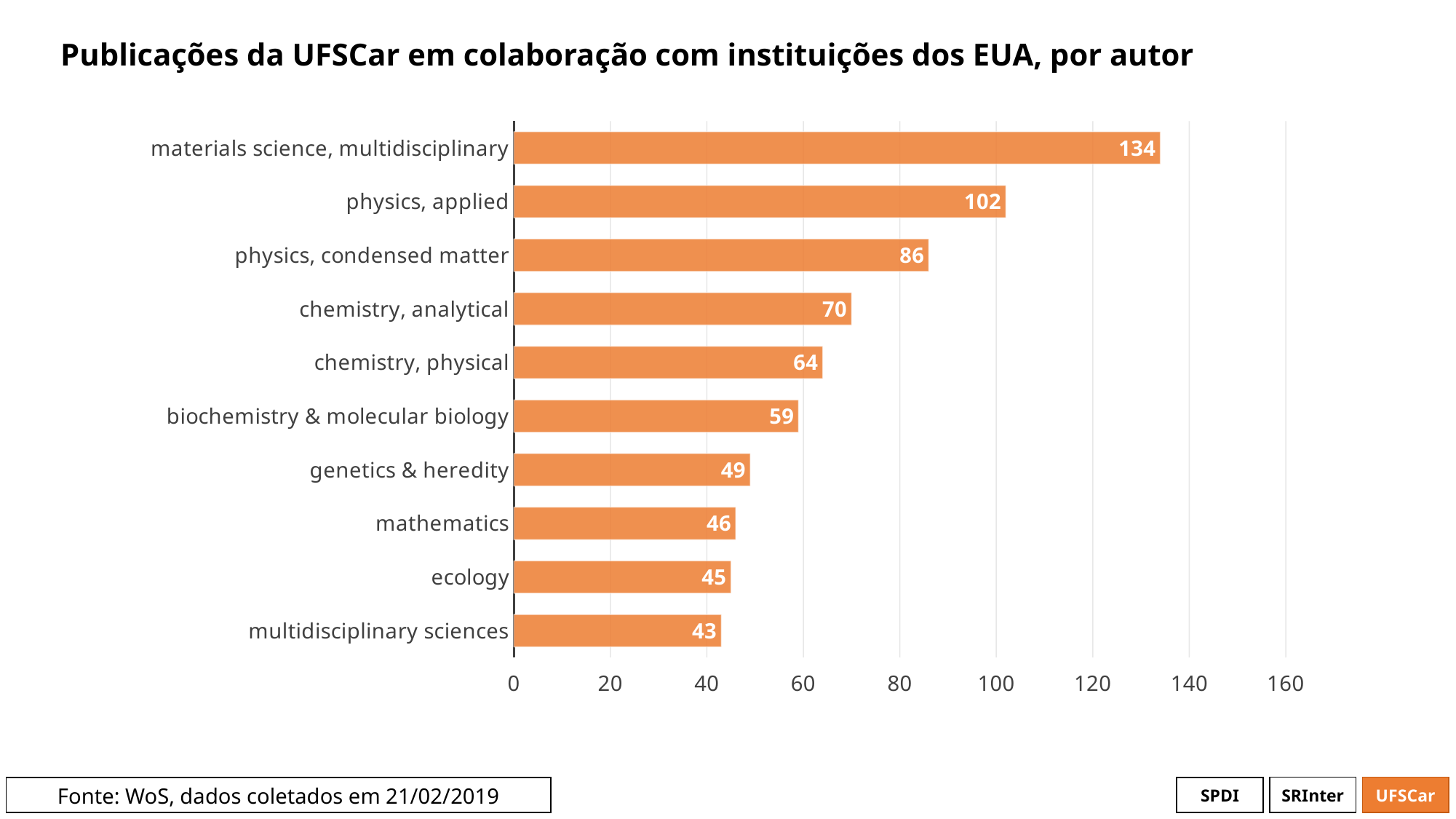
What is the value for ecology? 45 Which category has the highest value? materials science, multidisciplinary What is the title of the chart? Publicações da UFSCar em colaboração com instituições dos EUA, por autor What is the difference between the values for chemistry, analytical and chemistry, physical? 6 Which is larger, the value for genetics & heredity or the value for mathematics? genetics & heredity How many categories are shown in the chart? 10 What is the difference between the values for materials science, multidisciplinary and physics, applied? 32 What kind of chart is shown on the slide? bar chart Which category has the lowest value? multidisciplinary sciences What is the value for physics, applied? 102 Is the value for physics, condensed matter greater or less than 80? greater What is the value for biochemistry & molecular biology? 59